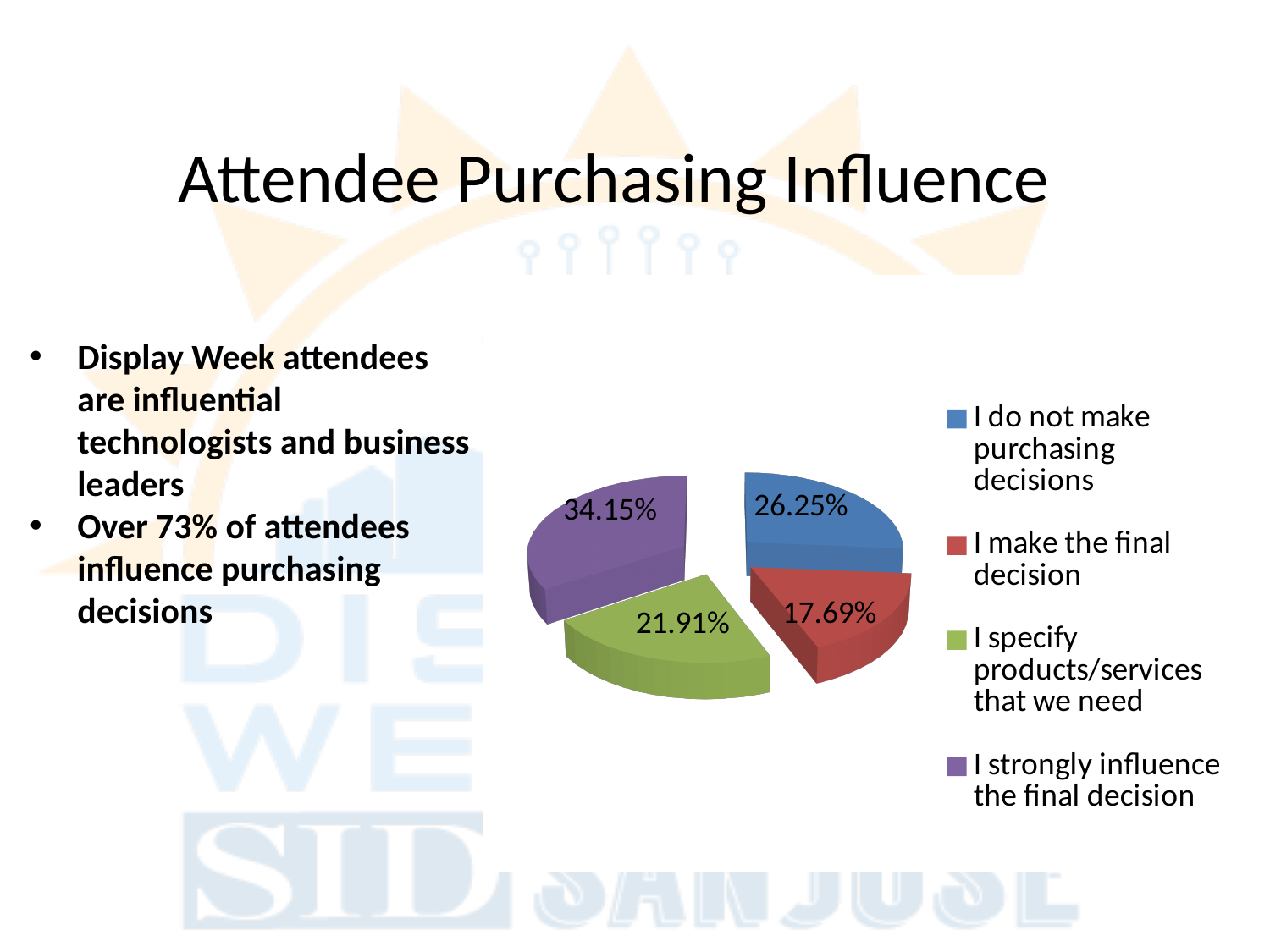
What colour is the slice for "I specify products/services that we need"? Green Which category has the largest share of the pie? I strongly influence the final decision What is the difference between the share for "I strongly influence the final decision" and the share for "I make the final decision"? 16.46% What percentage of attendees say "I strongly influence the final decision"? 34.15% How many slices does the pie chart have? 4 What percentage of attendees say "I do not make purchasing decisions"? 26.25% Which is larger: the share for "I do not make purchasing decisions" or the share for "I specify products/services that we need"? I do not make purchasing decisions Which category has the smallest share of the pie? I make the final decision What kind of chart is shown on the slide? Pie chart What is the combined share of "I make the final decision" and "I specify products/services that we need"? 39.60% What percentage of attendees say "I specify products/services that we need"? 21.91% What percentage of attendees say "I make the final decision"? 17.69%